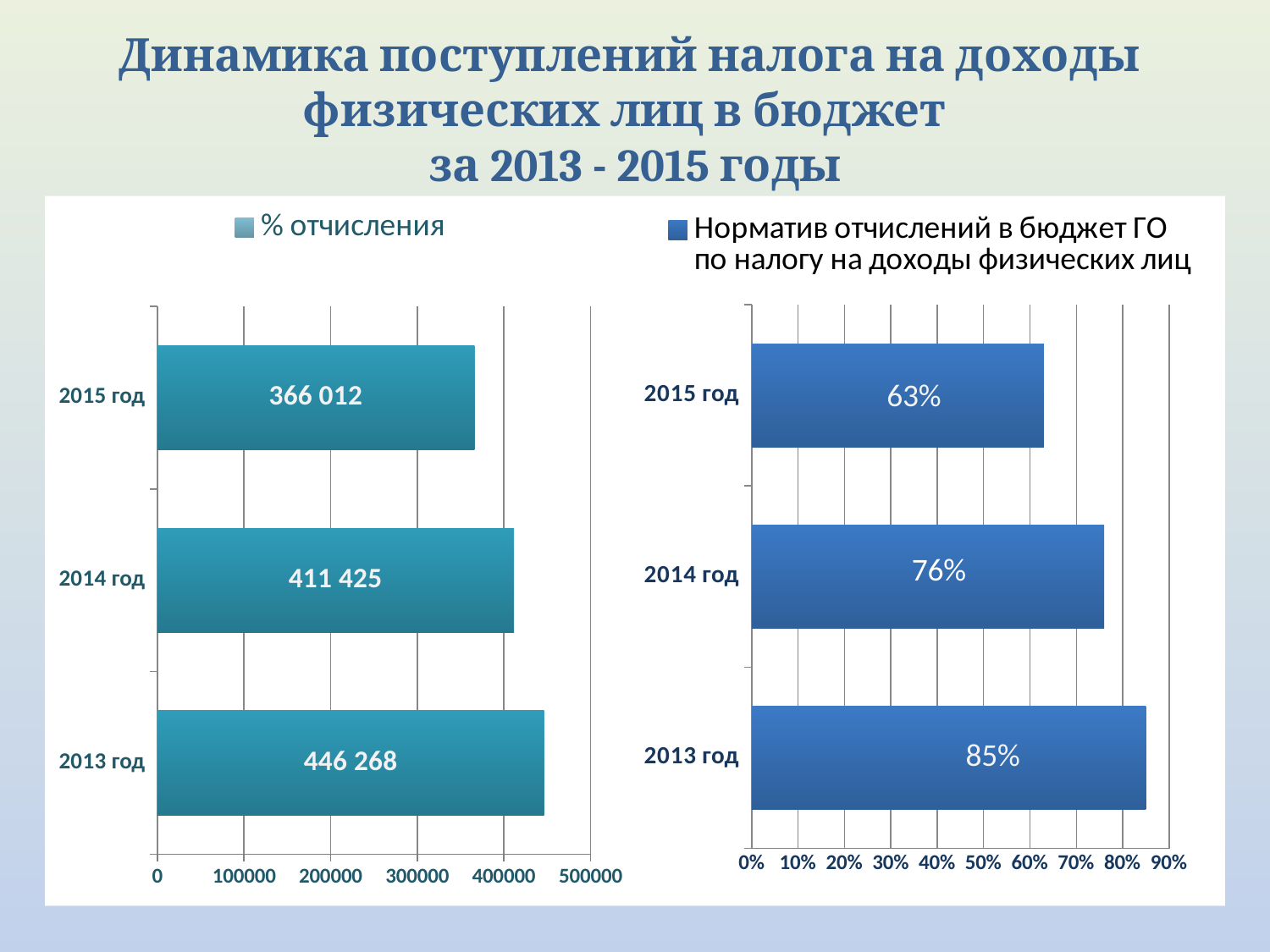
What kind of chart is the left chart? bar chart On the left chart, what is the value for 2013 год? 446 268 What is the legend entry of the left chart? % отчисления On the right chart, what is the value for 2014 год? 76% On the left chart, which is larger: the value for 2014 год or 2015 год? 2014 год On the right chart, what is the difference between the values for 2013 год and 2015 год? 22% On the right chart, which year has the lowest value? 2015 год On the right chart, what is the value for 2015 год? 63% How many categories (years) are shown on the right chart? 3 On the left chart, which year has the highest value? 2013 год On the left chart, what is the value for 2015 год? 366 012 On the left chart, what is the difference between the values for 2013 год and 2014 год? 34 843